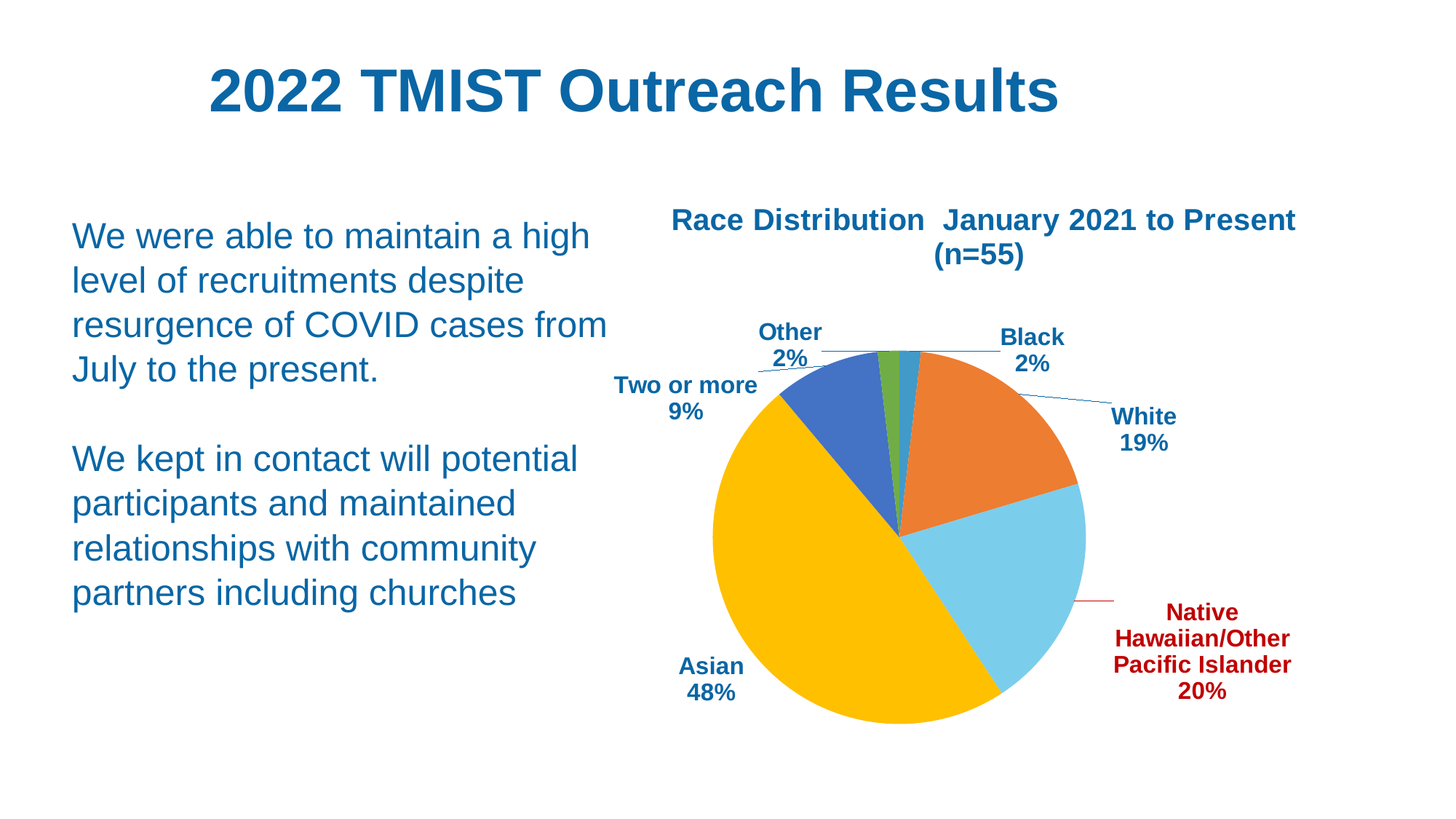
How many slices does the pie chart have? 6 What is the title of the chart? Race Distribution January 2021 to Present (n=55) What kind of chart is shown on the slide? pie chart What is the combined share of Black and Other? 4% What share of the pie is Asian? 48% Which is larger, the share for Native Hawaiian/Other Pacific Islander or the share for Two or more? Native Hawaiian/Other Pacific Islander What share of the pie is Two or more? 9% What is the difference between the Asian share and the White share? 29% What share of the pie is White? 19% What is the sample size (n) stated in the chart title? 55 What share of the pie is Native Hawaiian/Other Pacific Islander? 20% Which category has the largest share of the pie? Asian